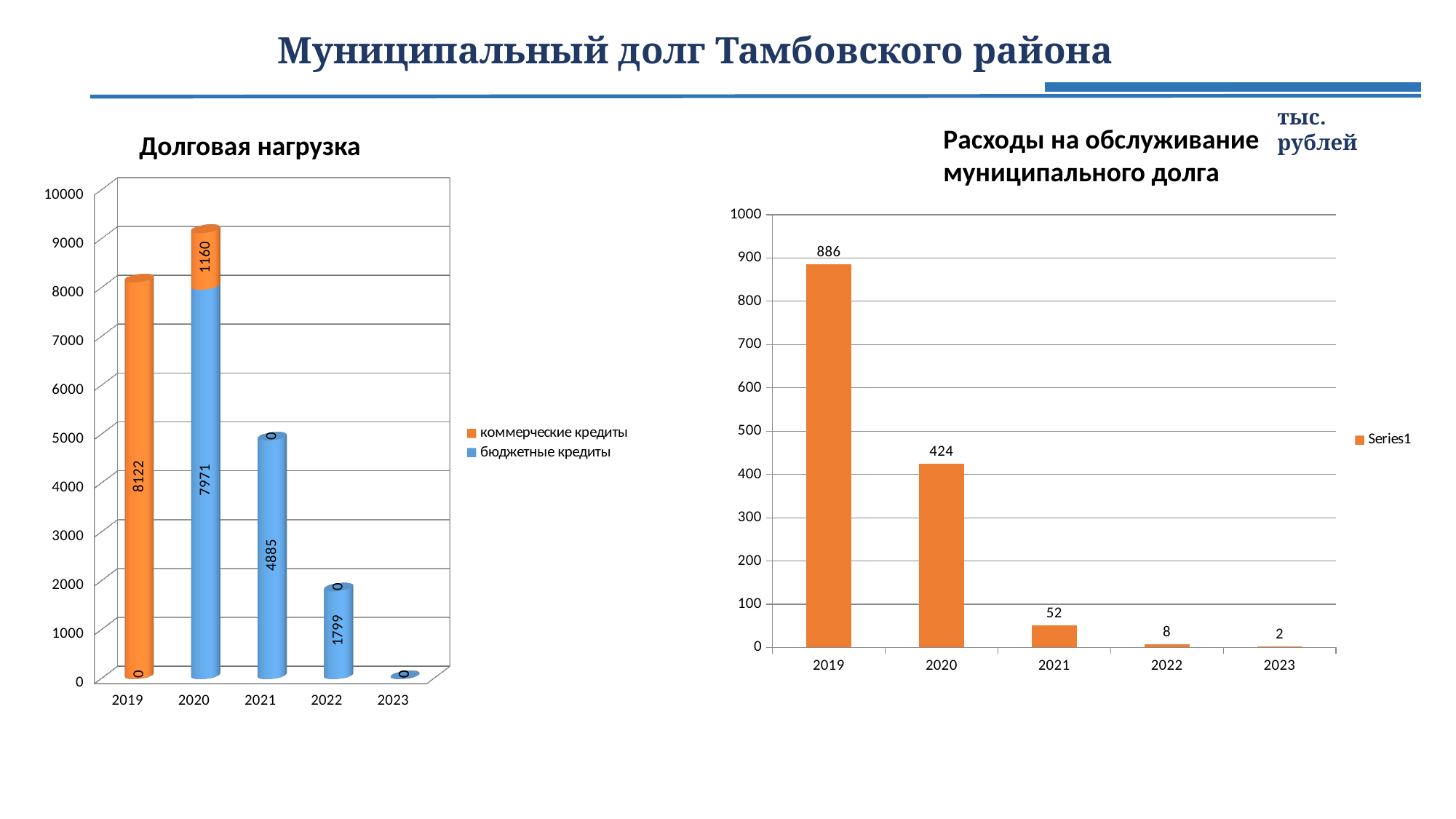
In the chart 'Долговая нагрузка', what is the value of коммерческие кредиты for 2020? 1160 What kind of chart is 'Расходы на обслуживание муниципального долга'? bar chart In the chart 'Расходы на обслуживание муниципального долга', what is the difference between the values for 2019 and 2020? 462 In the chart 'Долговая нагрузка', how many series does the legend list? 2 In the chart 'Расходы на обслуживание муниципального долга', what is the value for 2019? 886 In the chart 'Долговая нагрузка', what is the total of the stacked bar for 2020? 9131 In the chart 'Расходы на обслуживание муниципального долга', do the values rise or fall from 2019 to 2023? fall In the chart 'Долговая нагрузка', what is the value of бюджетные кредиты for 2020? 7971 In the chart 'Расходы на обслуживание муниципального долга', how many years are shown on the x axis? 5 In the chart 'Долговая нагрузка', what is the value of коммерческие кредиты for 2019? 8122 In the chart 'Долговая нагрузка', what is the difference between бюджетные кредиты in 2021 and 2022? 3086 In the chart 'Расходы на обслуживание муниципального долга', which year has the lowest value? 2023